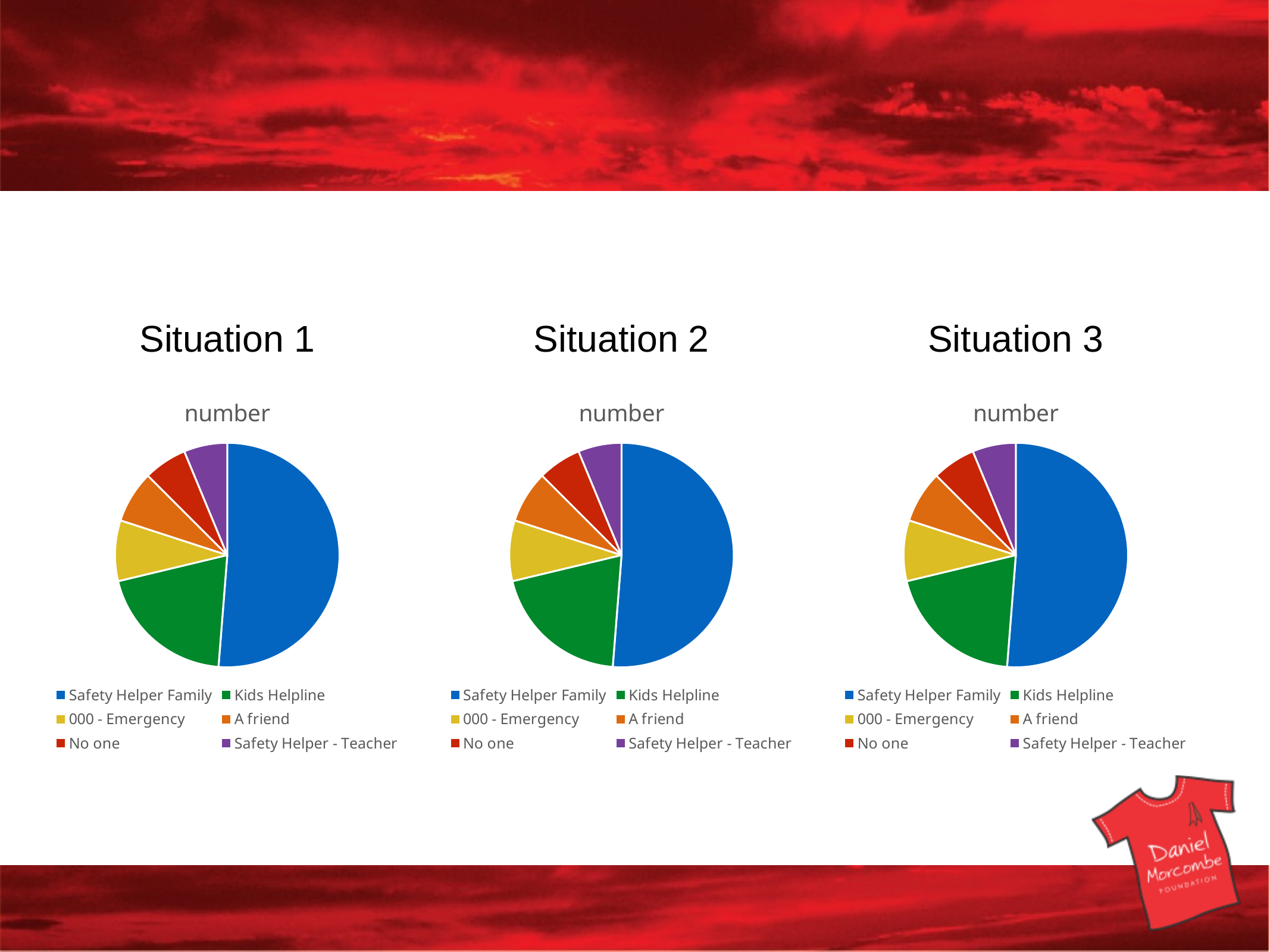
How many pie charts are shown on the slide? 3 In the Situation 3 pie chart, which category has the largest slice? Safety Helper Family In the Situation 1 pie chart, which category has the largest slice? Safety Helper Family In the Situation 2 pie chart, which category has the largest slice? Safety Helper Family What is the title shown above each of the three pie charts? number How many entries does the legend of the Situation 3 chart list? 6 In the Situation 2 pie chart, which slice is larger: Safety Helper Family or Kids Helpline? Safety Helper Family What colour represents Kids Helpline in the Situation 1 pie chart? green What kind of chart is used for Situation 1? pie chart In the Situation 1 pie chart, which slice is larger: Kids Helpline or 000 - Emergency? Kids Helpline How many categories does the Situation 2 pie chart show? 6 In the Situation 3 pie chart, which slice is larger: A friend or Kids Helpline? Kids Helpline